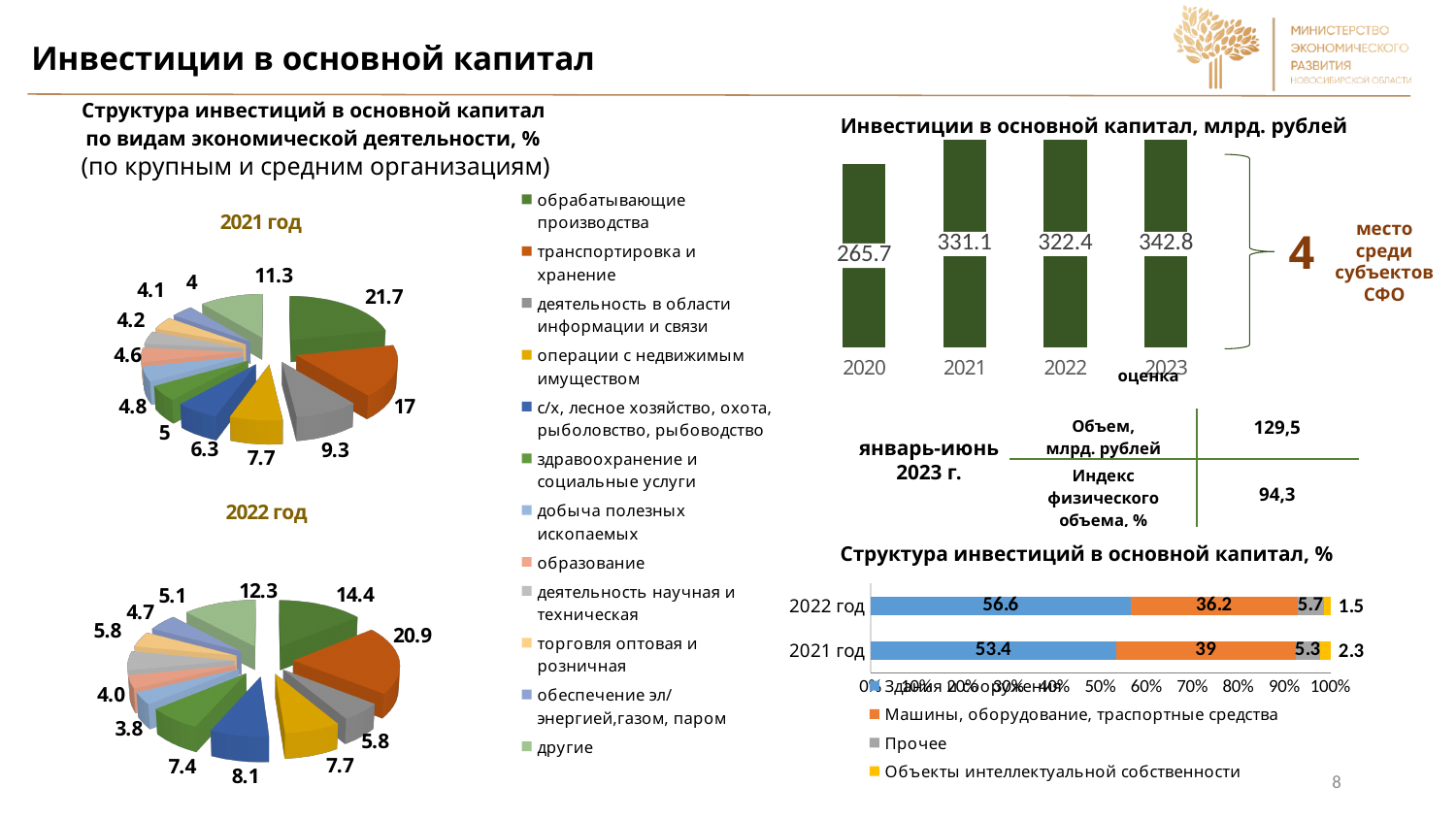
In the bar chart 'Инвестиции в основной капитал, млрд. рублей', which year has the lowest value? 2020 In the bar chart 'Инвестиции в основной капитал, млрд. рублей', what is the value for 2022? 322.4 What kind of chart is used for '2021 год' on the left side of the slide? Pie chart In the bar chart 'Инвестиции в основной капитал, млрд. рублей', how many years are shown? 4 In the bar chart 'Инвестиции в основной капитал, млрд. рублей', which year has the highest value? 2023 In the stacked bar chart 'Структура инвестиций в основной капитал, %', what is the value for 'Машины, оборудование, траспортные средства' in 2022 год? 36.2 In the bar chart 'Инвестиции в основной капитал, млрд. рублей', what is the difference between the 2021 and 2020 values? 65.4 In the bar chart 'Инвестиции в основной капитал, млрд. рублей', what is the value for 2020? 265.7 In the stacked bar chart 'Структура инвестиций в основной капитал, %', what is the value for 'Объекты интеллектуальной собственности' in 2021 год? 2.3 In the stacked bar chart 'Структура инвестиций в основной капитал, %', how many series does the legend list? 4 In the '2021 год' pie chart, what is the largest value shown? 21.7 In the stacked bar chart 'Структура инвестиций в основной капитал, %', is the first (blue) segment larger in 2022 год or 2021 год? 2022 год